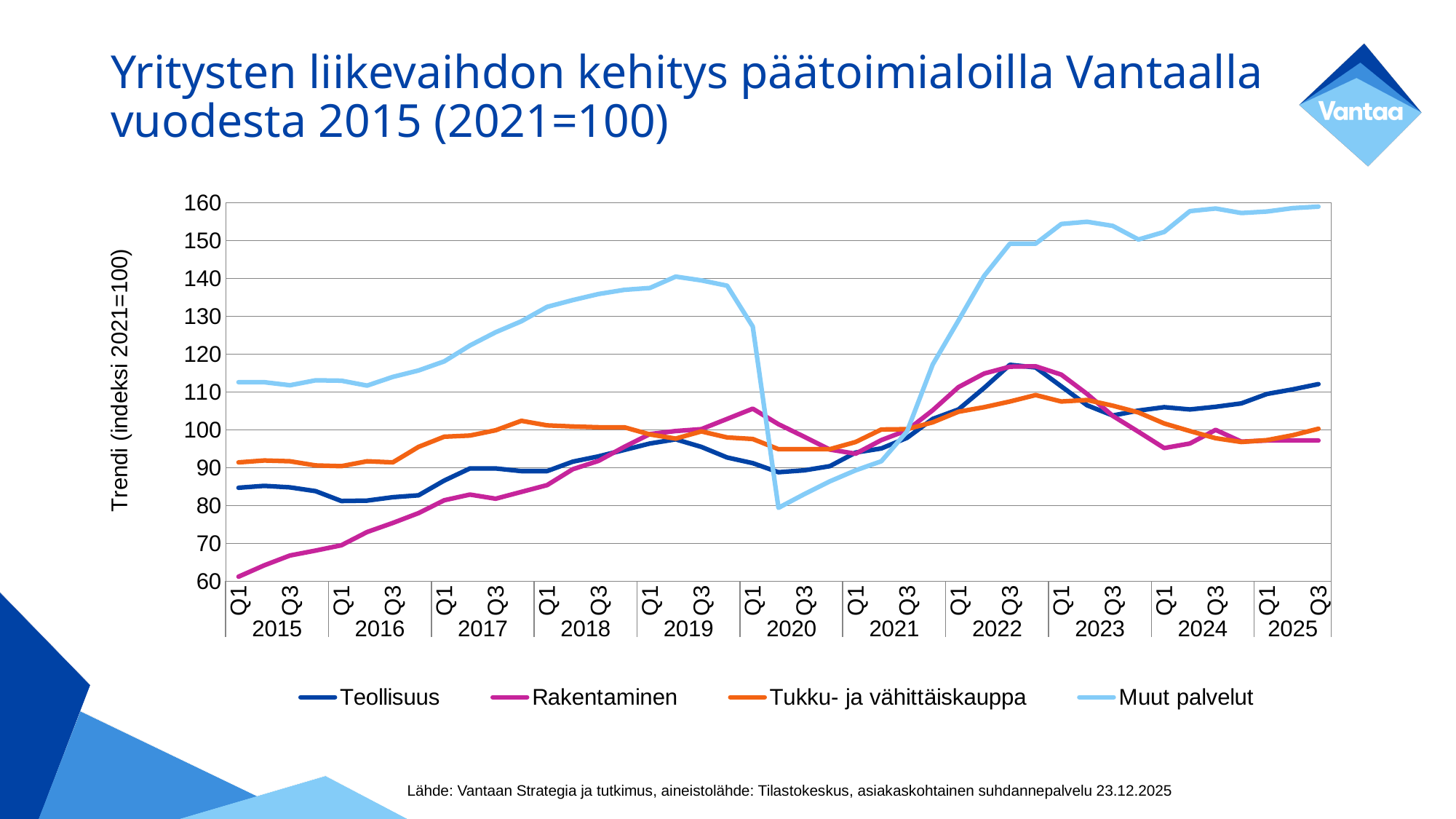
Which series has the highest value in Q3 2025? Muut palvelut What are the four series named in the legend? Teollisuus, Rakentaminen, Tukku- ja vähittäiskauppa, Muut palvelut Is the value for Muut palvelut in Q3 2020 greater or less than 90? less Is the value for Teollisuus in Q3 2025 greater or less than 100? greater Is the value for Tukku- ja vähittäiskauppa in Q1 2015 greater or less than 100? less Which series has the lowest value in Q1 2015? Rakentaminen How many series does the legend list? 4 What kind of chart is shown on the slide? line chart Does the Rakentaminen series rise or fall from Q1 2015 to Q1 2019? rise What is the title of the vertical axis? Trendi (indeksi 2021=100)